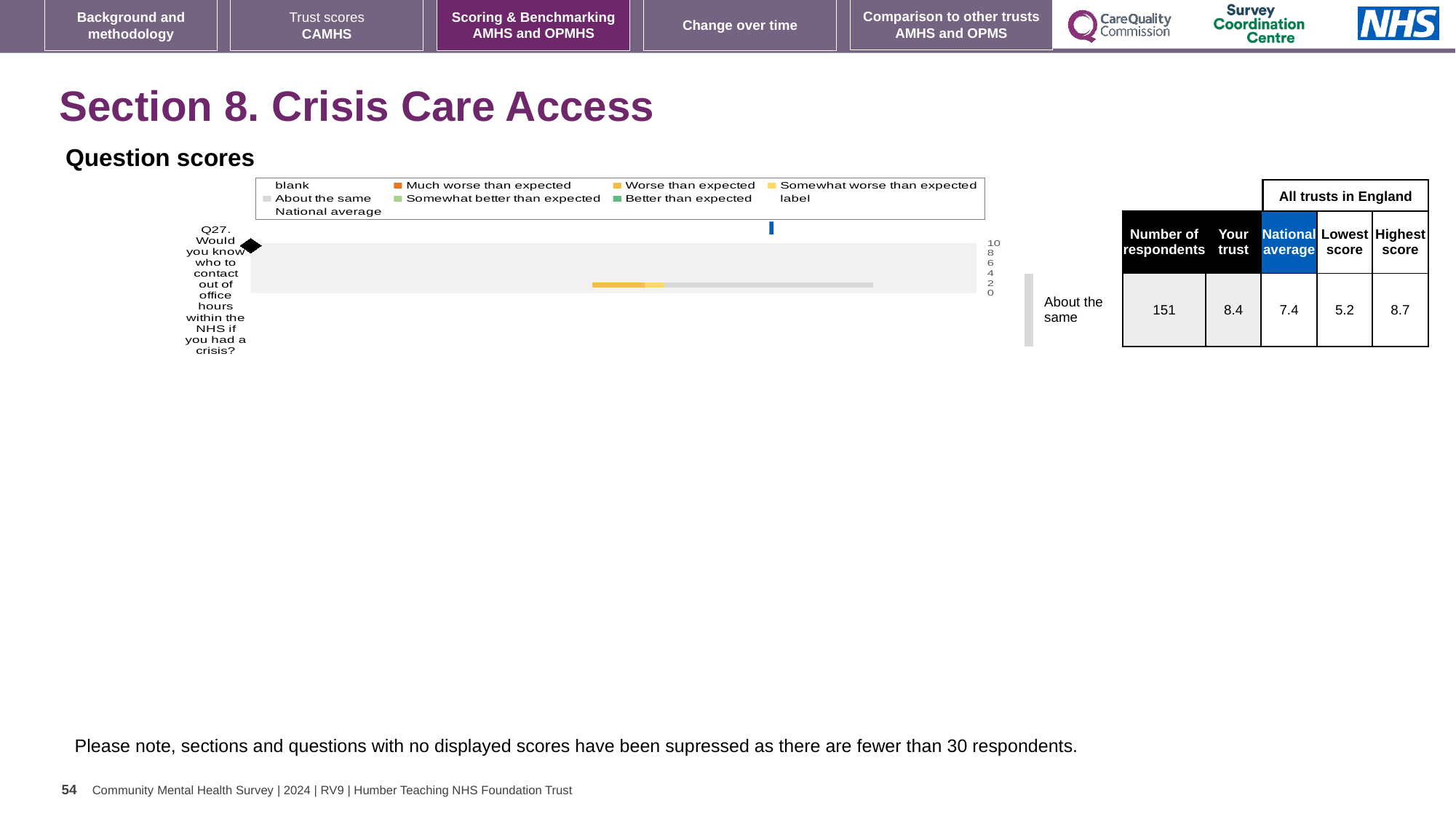
What is the highest score among all trusts in England for Q27? 8.7 What benchmark category is shown for Q27 on the chart? About the same Which is larger for Q27, the trust's score or the national average? Your trust What is the lowest score among all trusts in England for Q27? 5.2 By how much does the trust's score for Q27 exceed the national average? 1.0 How many respondents answered Q27 (Would you know who to contact out of office hours within the NHS if you had a crisis)? 151 What kind of chart is used to show the Q27 question score? Bar chart Which is larger for Q27, the lowest score or the national average? National average What is the national average score for Q27? 7.4 How many questions are plotted on the Question scores chart? 1 What is the difference between the highest and lowest scores for Q27 across all trusts in England? 3.5 What is the trust's score for Q27? 8.4